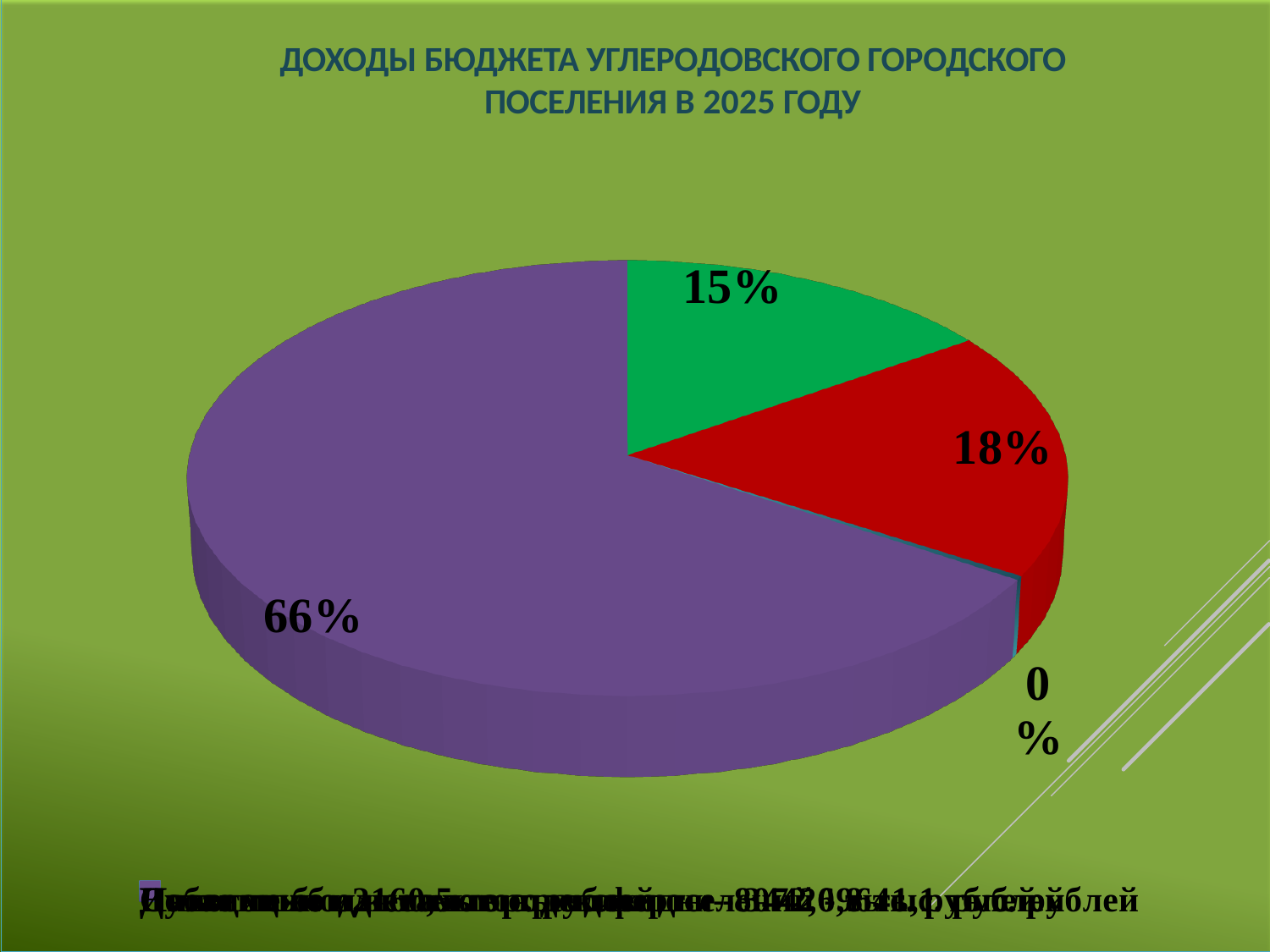
What is the title of the chart on the slide? ДОХОДЫ БЮДЖЕТА УГЛЕРОДОВСКОГО ГОРОДСКОГО ПОСЕЛЕНИЯ В 2025 ГОДУ Which slice is larger, the green slice or the red slice? the red slice What colour is the largest slice of the pie chart? purple What share of the pie does the purple slice represent? 66% What is the difference in percentage points between the purple slice and the red slice? 48 What kind of chart is shown on the slide? pie chart What share of the pie does the green slice represent? 15% How many percentage labels are shown on the pie chart? 4 What share of the pie does the red slice represent? 18% What is the difference in percentage points between the red slice and the green slice? 3 What is the smallest share shown on the pie chart? 0% What is the largest share shown on the pie chart? 66%